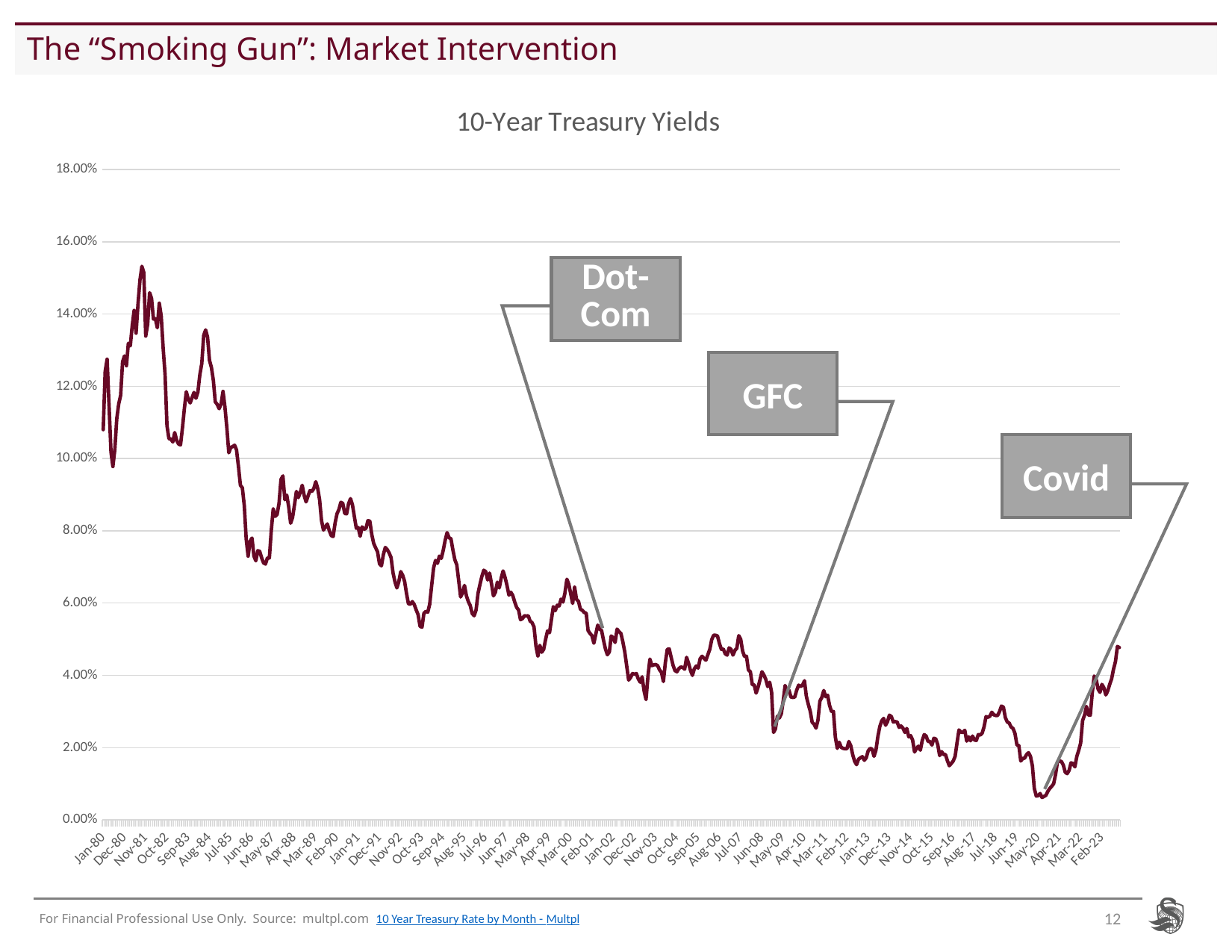
What is the highest value shown on the vertical axis? 18.00% How many event annotations (callout boxes) are placed on the chart? 3 Is the lowest point of the yield line, around 2020, greater or less than 2.00%? less Is the yield at the point labelled Dot-Com greater or less than 4.00%? greater What is the title of the chart? 10-Year Treasury Yields Overall, do the 10-year Treasury yields rise or fall from Jan-80 to the end of the series? Fall Is the highest point of the yield line greater or less than 14.00%? greater What kind of chart is shown on the slide? Line chart In which decade does the yield line reach its highest values? 1980s Which is higher, the yield at the Dot-Com annotation or the yield at the Covid annotation? Dot-Com